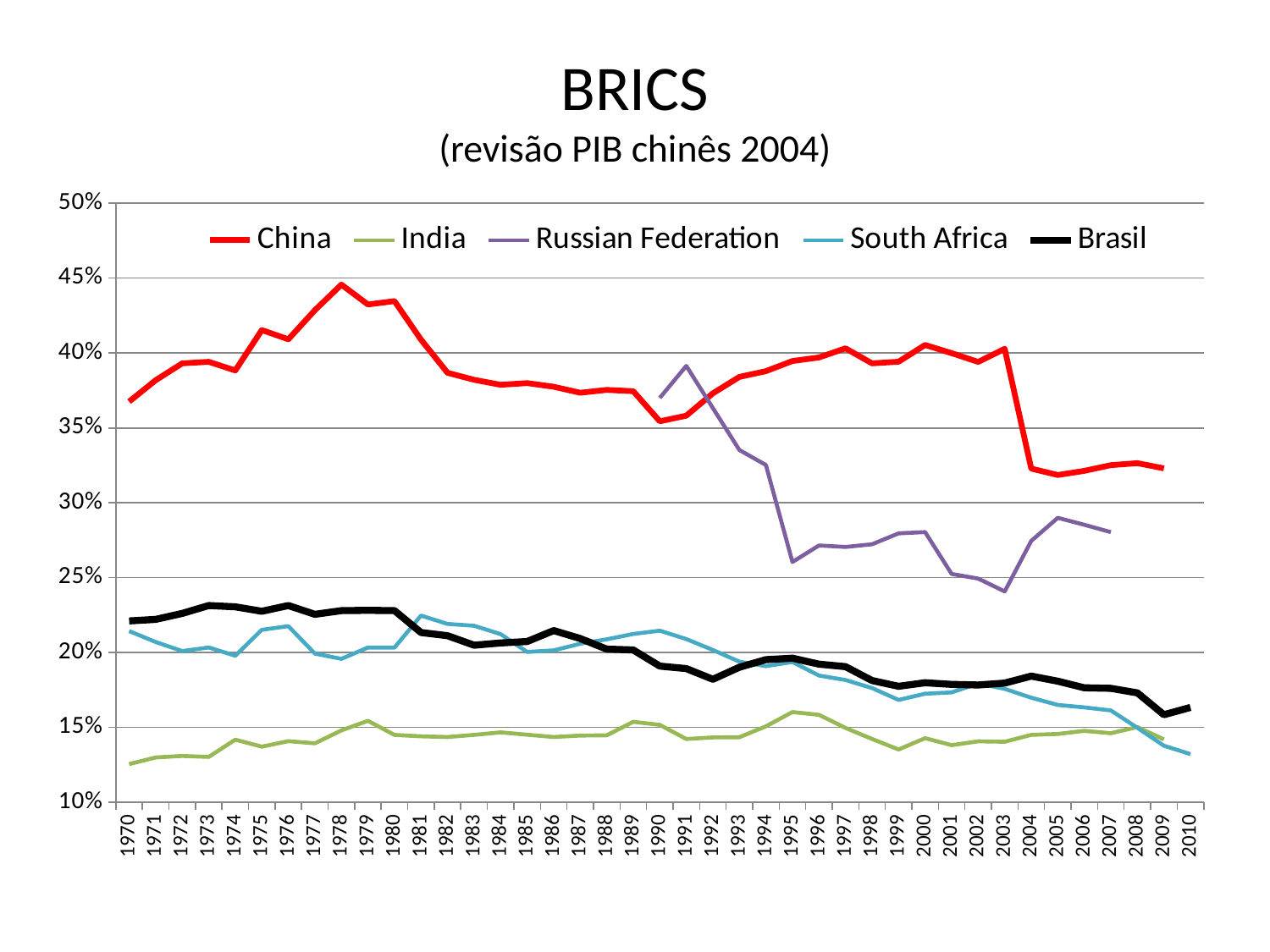
Is the value for China in 1978 greater or less than 40%? greater How many series does the legend list? 5 In 2005, which is higher: Brasil or South Africa? Brasil Is the value for Russian Federation in 2003 greater or less than 25%? less In 1995, which is higher: Russian Federation or Brasil? Russian Federation What kind of chart is shown on the slide? line chart Does the Brasil line rise or fall overall from 1970 to 2010? fall How many years are shown on the x axis? 41 Is the value for China in 2004 greater or less than 35%? less Which series has the lowest value in 1970? India What is the title of the chart? BRICS